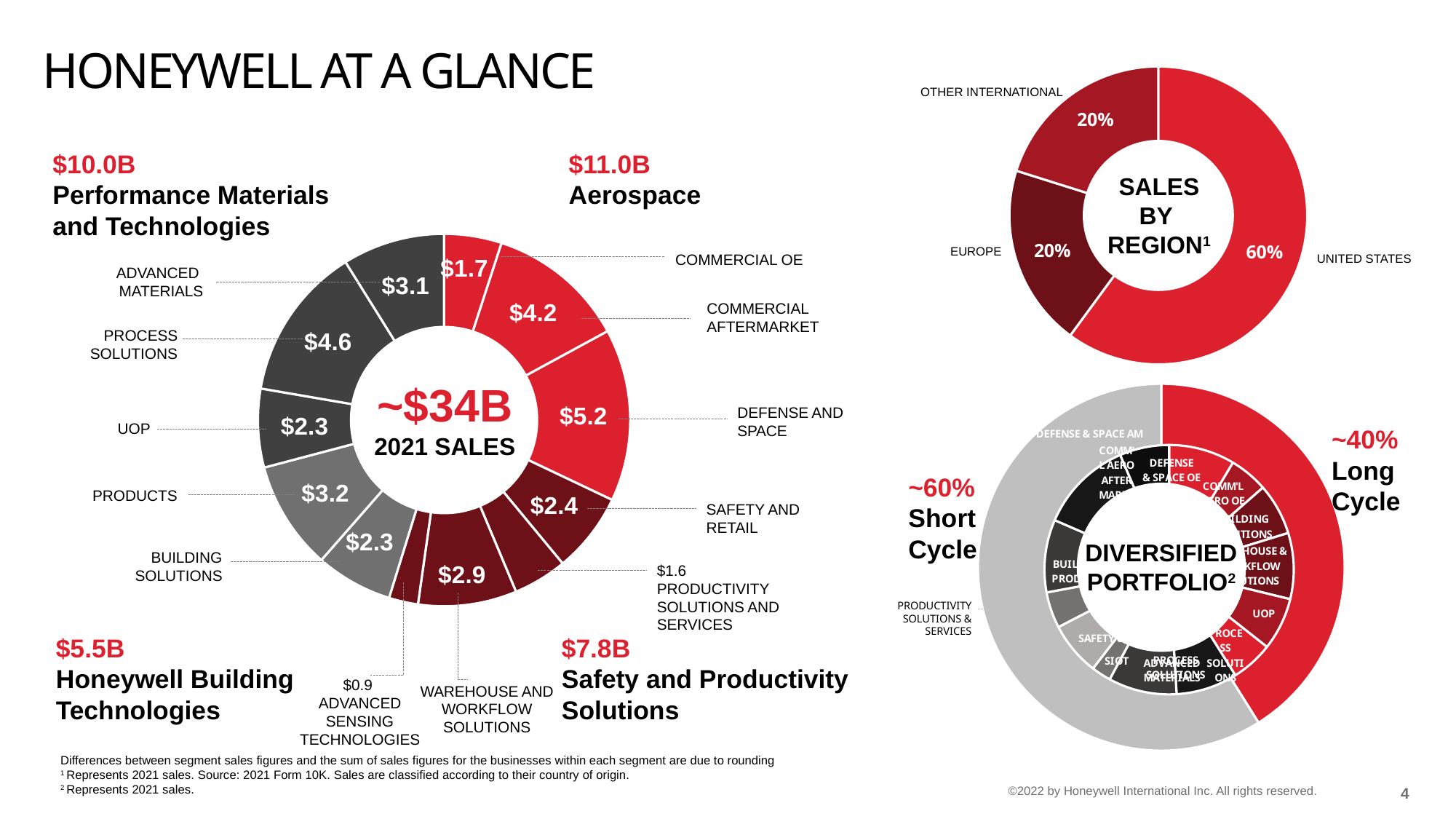
In the Sales by Region chart, what share of sales comes from the United States? 60% What kind of chart is the Sales by Region chart? Donut (pie) chart In the 2021 Sales donut chart, which is larger: Products or Warehouse and Workflow Solutions? Products How many business slices are shown in the 2021 Sales donut chart? 12 In the Diversified Portfolio chart, what share is labelled Short Cycle? ~60% In the 2021 Sales donut chart, which business has the largest slice? Defense and Space What total sales figure is printed in the centre of the 2021 Sales donut chart? ~$34B In the 2021 Sales donut chart, what is the difference between the Process Solutions value and the Advanced Materials value? $1.5 In the 2021 Sales donut chart, what is the value shown for Commercial Aftermarket? $4.2 In the 2021 Sales donut chart, what is the value shown for Defense and Space? $5.2 In the 2021 Sales donut chart, which business has the smallest slice? Advanced Sensing Technologies In the Sales by Region chart, what share of sales comes from Europe? 20%